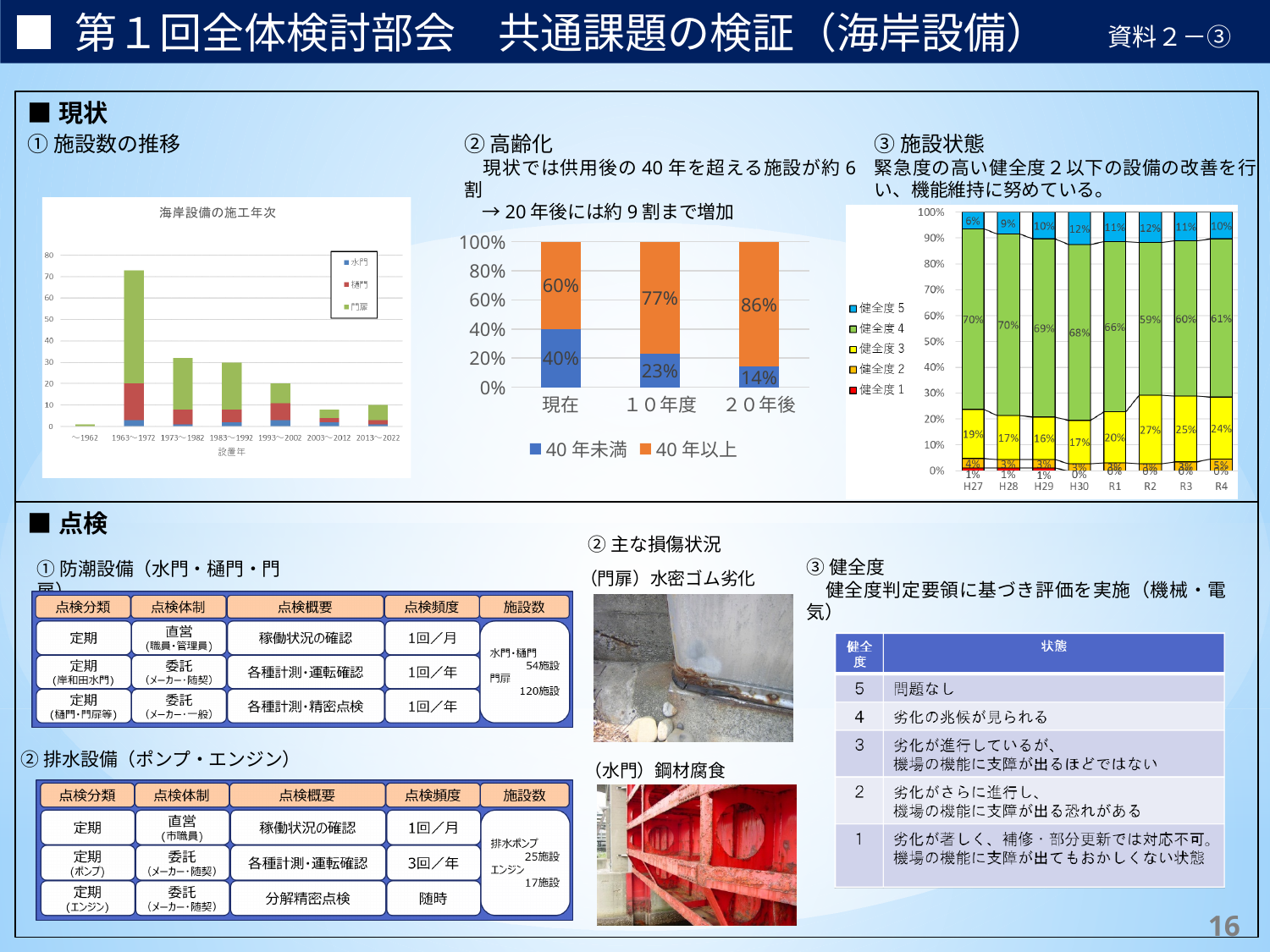
In the right chart (施設状態), what is the value for 健全度 4 in H27? 70% In the right chart (施設状態), how many series does the legend list? 5 In the middle chart (高齢化), what is the value for 40 年未満 at 20年後? 14% In the right chart (施設状態), what is the value for 健全度 3 in R2? 27% In the middle chart (高齢化), what is the value for 40 年以上 at 現在? 60% In the middle chart (高齢化), how many series does the legend list? 2 In the right chart (施設状態), how many years are shown on the x axis? 8 In the middle chart (高齢化), what is the difference between the 40 年以上 values at 20年後 and 現在? 26% What kind of chart is the left chart (海岸設備の施工年次)? stacked bar chart In the right chart (施設状態), which year has the highest value for 健全度 3? R2 In the middle chart (高齢化), does the share of 40 年以上 rise or fall from 現在 to 20年後? rise In the left chart (海岸設備の施工年次), which 設置年 category has the tallest bar? 1963～1972